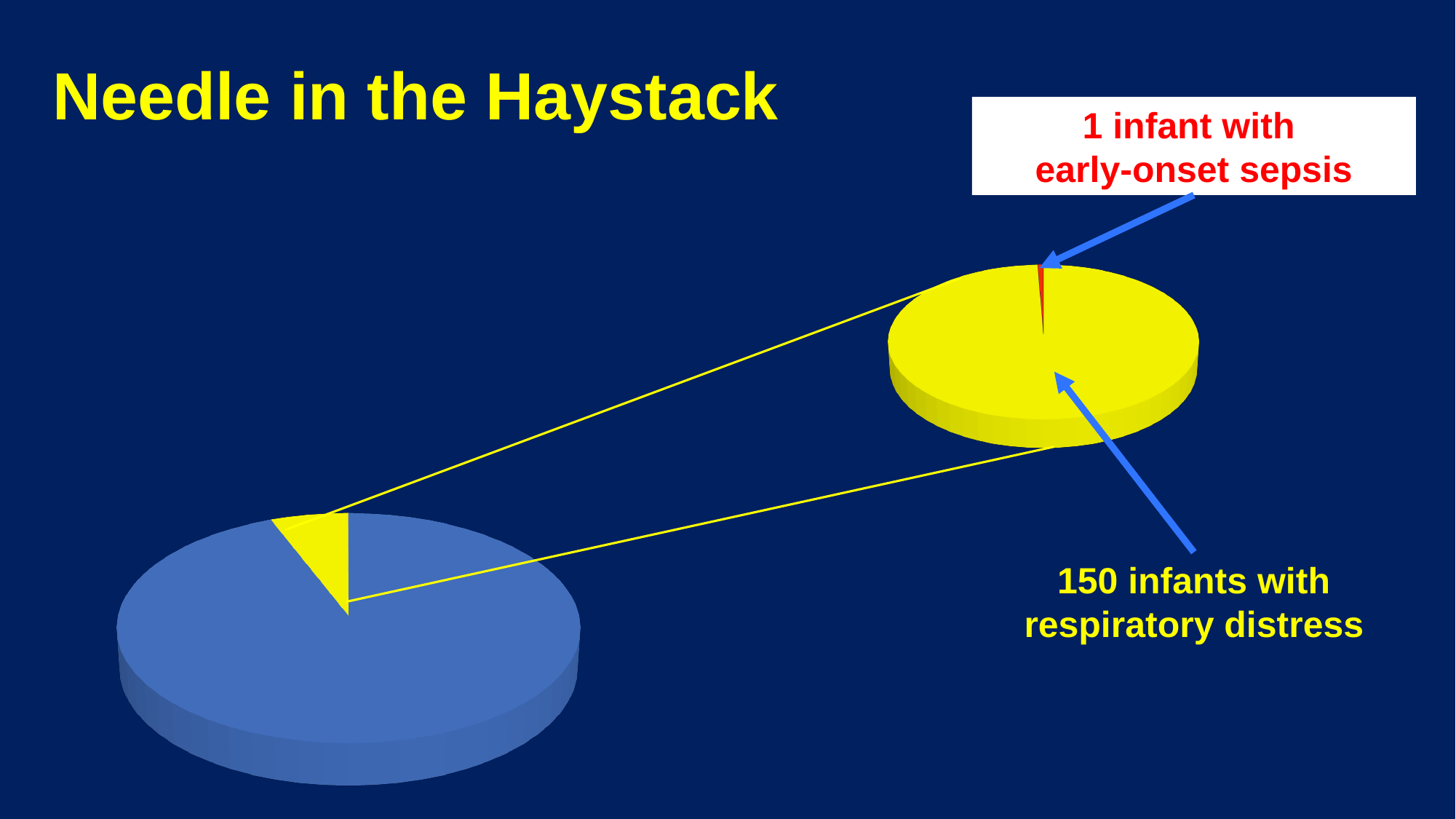
What colour is the slice representing the 1 infant with early-onset sepsis? red What kind of chart is used on the slide? pie chart In the top-right pie chart, which group is larger: infants with respiratory distress or infants with early-onset sepsis? infants with respiratory distress What is the title of the slide? Needle in the Haystack How many slices does the top-right pie chart have? 2 What is the difference between the number of infants with respiratory distress and the number with early-onset sepsis? 149 How many infants with early-onset sepsis are shown in the top-right pie chart? 1 In the top-right pie chart, which group is the largest? 150 infants with respiratory distress How many infants with respiratory distress are shown in the top-right pie chart? 150 In the top-right pie chart, which group is the smallest? 1 infant with early-onset sepsis